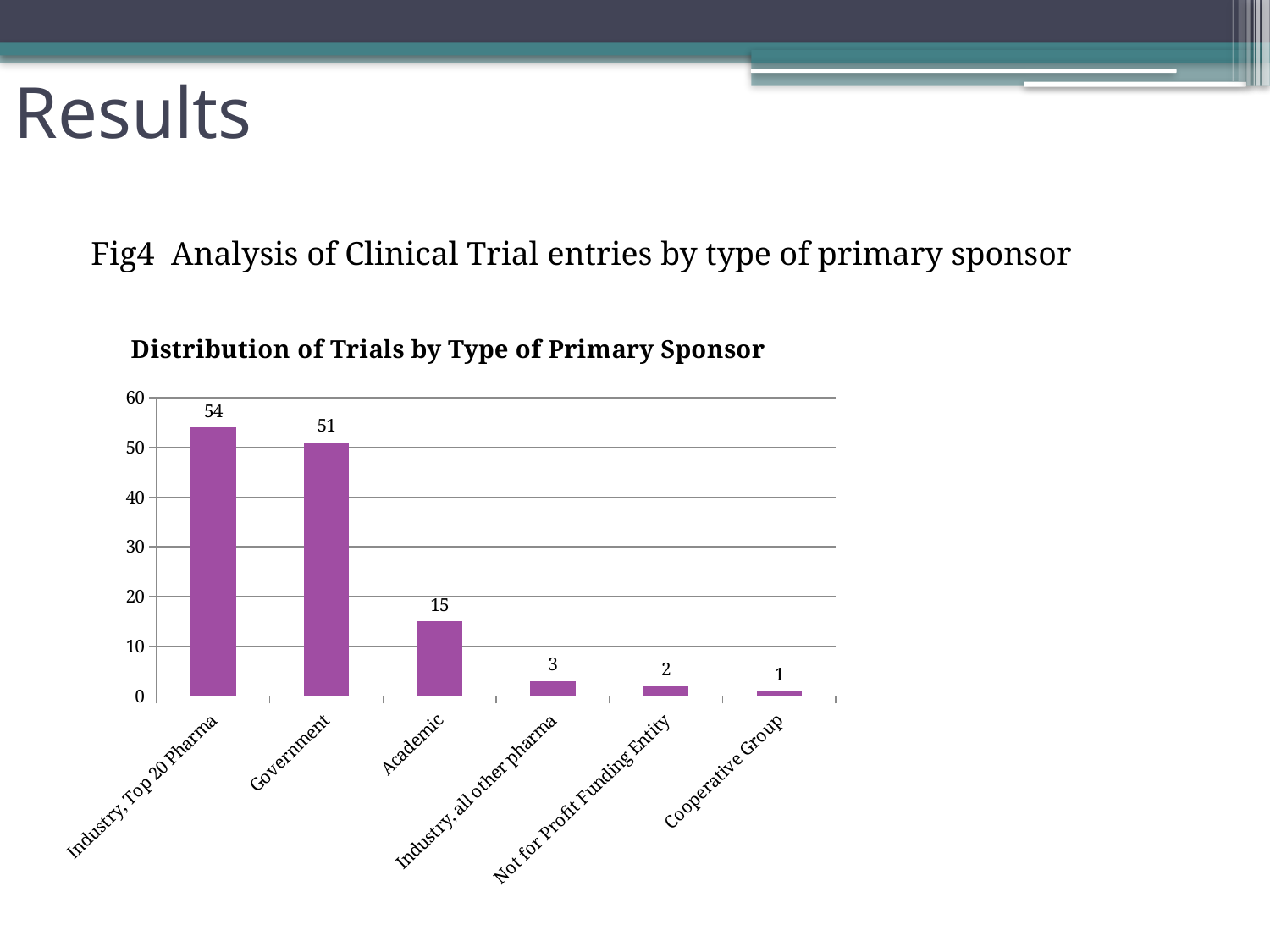
What is the title of the chart? Distribution of Trials by Type of Primary Sponsor How many categories are shown on the x axis? 6 What kind of chart is shown? bar chart What is the difference between the values for Industry, Top 20 Pharma and Government? 3 Which is larger, the value for Academic or the value for Industry, all other pharma? Academic What is the value for Academic? 15 What is the difference between the values for Academic and Industry, all other pharma? 12 Which category has the lowest value? Cooperative Group What is the value for Not for Profit Funding Entity? 2 Which category has the highest value? Industry, Top 20 Pharma What is the value for Government? 51 Is the value for Government greater or less than 40? greater